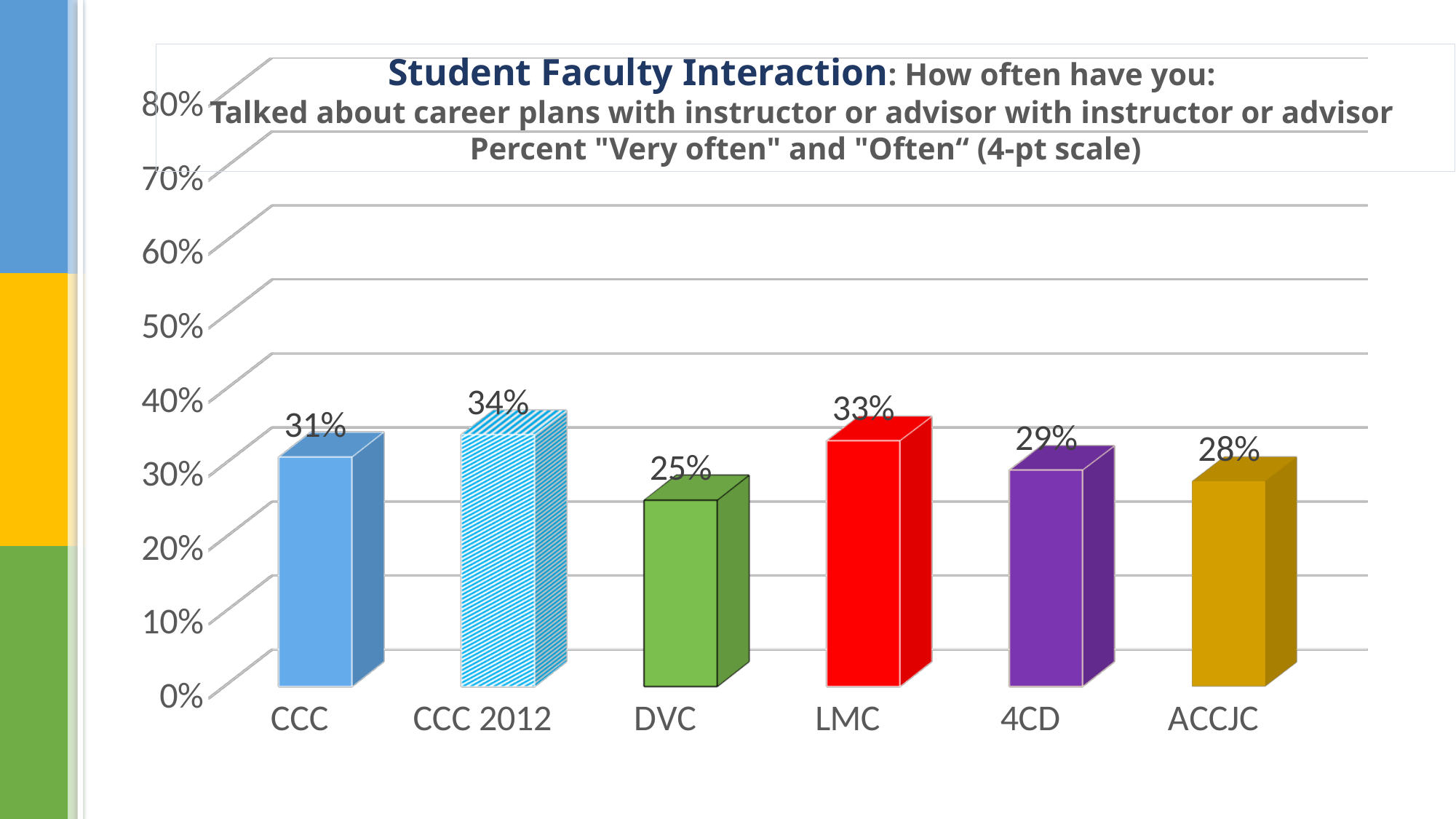
Is the value for LMC greater or less than 30%? greater What is the value for CCC? 31% What is the difference between the values for LMC and DVC? 8% What is the value for ACCJC? 28% What kind of chart is this? bar chart What is the value for DVC? 25% Which is larger, the value for 4CD or the value for DVC? 4CD What is the difference between the values for CCC 2012 and CCC? 3% How many categories are shown on the x axis? 6 What colour is the bar for LMC? red Which category has the highest value? CCC 2012 Which category has the lowest value? DVC